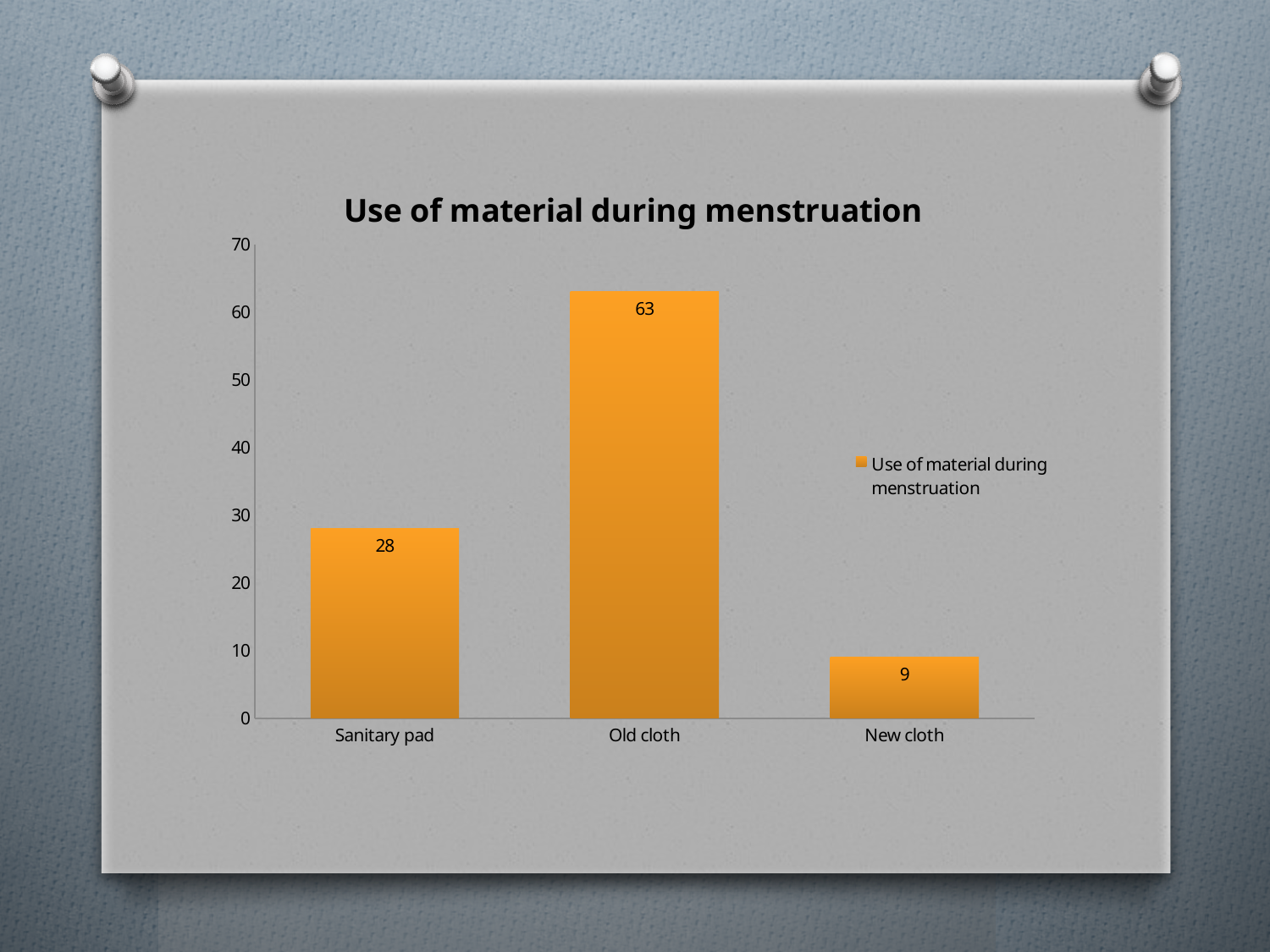
Is the value for Old cloth greater or less than 60? greater What is the value for New cloth? 9 What is the title of the chart? Use of material during menstruation What is the value for Sanitary pad? 28 What is the value for Old cloth? 63 Which category has the lowest value? New cloth What is the difference between the values for Old cloth and Sanitary pad? 35 What kind of chart is shown on the slide? Bar chart Which is larger, the value for Sanitary pad or the value for New cloth? Sanitary pad Which category has the highest value? Old cloth How many categories are shown on the x axis? 3 What is the difference between the values for Sanitary pad and New cloth? 19